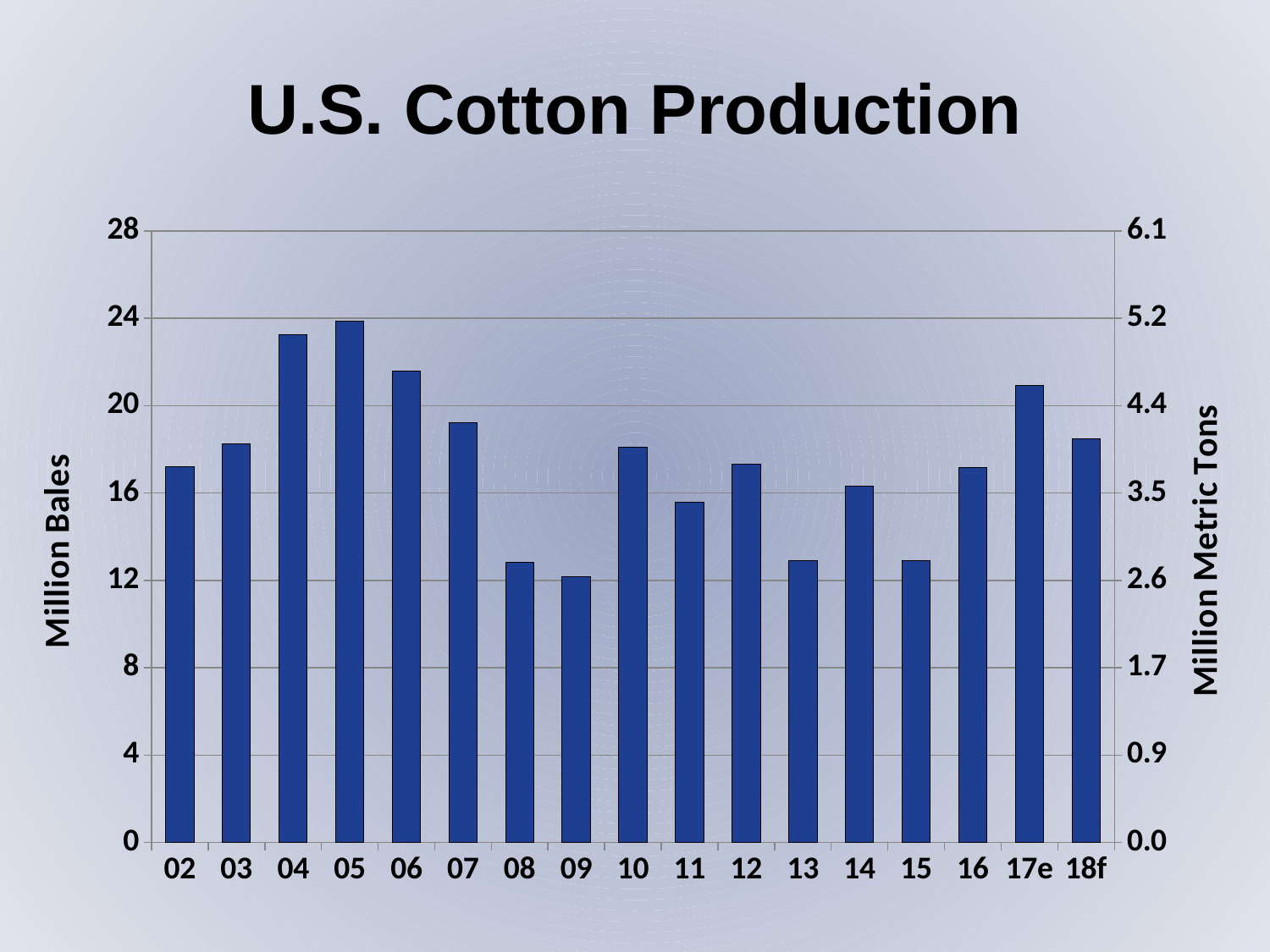
Which year has the lowest cotton production? 09 Is the value for 06 greater or less than 20 million bales? greater Do the values rise or fall from 05 to 09? fall Which year has the highest cotton production? 05 What kind of chart is shown on the slide? bar chart How many years (bars) are shown on the x axis? 17 Which is larger, the value for 06 or the value for 07? 06 Is the value for 11 greater or less than 16 million bales? less Is the value for 08 greater or less than 16 million bales? less What is the label on the left vertical axis? Million Bales What is the title of the chart? U.S. Cotton Production